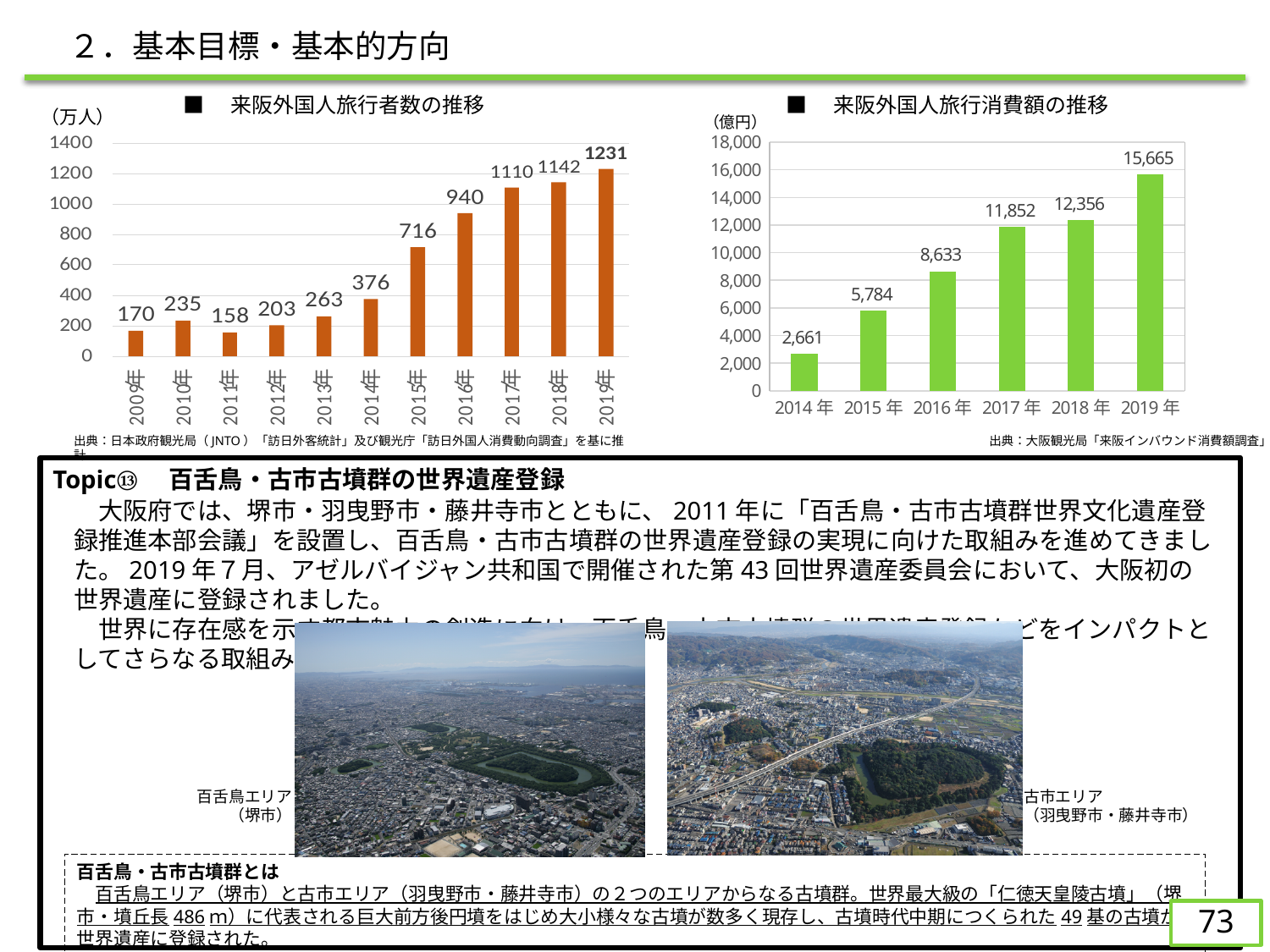
In the left chart (来阪外国人旅行者数の推移), how many years are shown on the x axis? 11 What unit is shown on the vertical axis of the right chart (来阪外国人旅行消費額の推移)? 億円 In the left chart (来阪外国人旅行者数の推移), which is larger, the value for 2010年 or 2012年? 2010年 In the left chart (来阪外国人旅行者数の推移), which year has the lowest value? 2011年 In the right chart (来阪外国人旅行消費額の推移), what is the value for 2017年? 11,852 In the right chart (来阪外国人旅行消費額の推移), do the values rise or fall from 2014年 to 2019年? rise In the right chart (来阪外国人旅行消費額の推移), which year has the highest value? 2019年 In the left chart (来阪外国人旅行者数の推移), what is the value for 2014年? 376 In the left chart (来阪外国人旅行者数の推移), what is the value for 2019年? 1231 In the left chart (来阪外国人旅行者数の推移), what is the difference between the values for 2016年 and 2015年? 224 In the right chart (来阪外国人旅行消費額の推移), what is the difference between the values for 2019年 and 2018年? 3,309 What kind of chart is the right chart (来阪外国人旅行消費額の推移)? bar chart